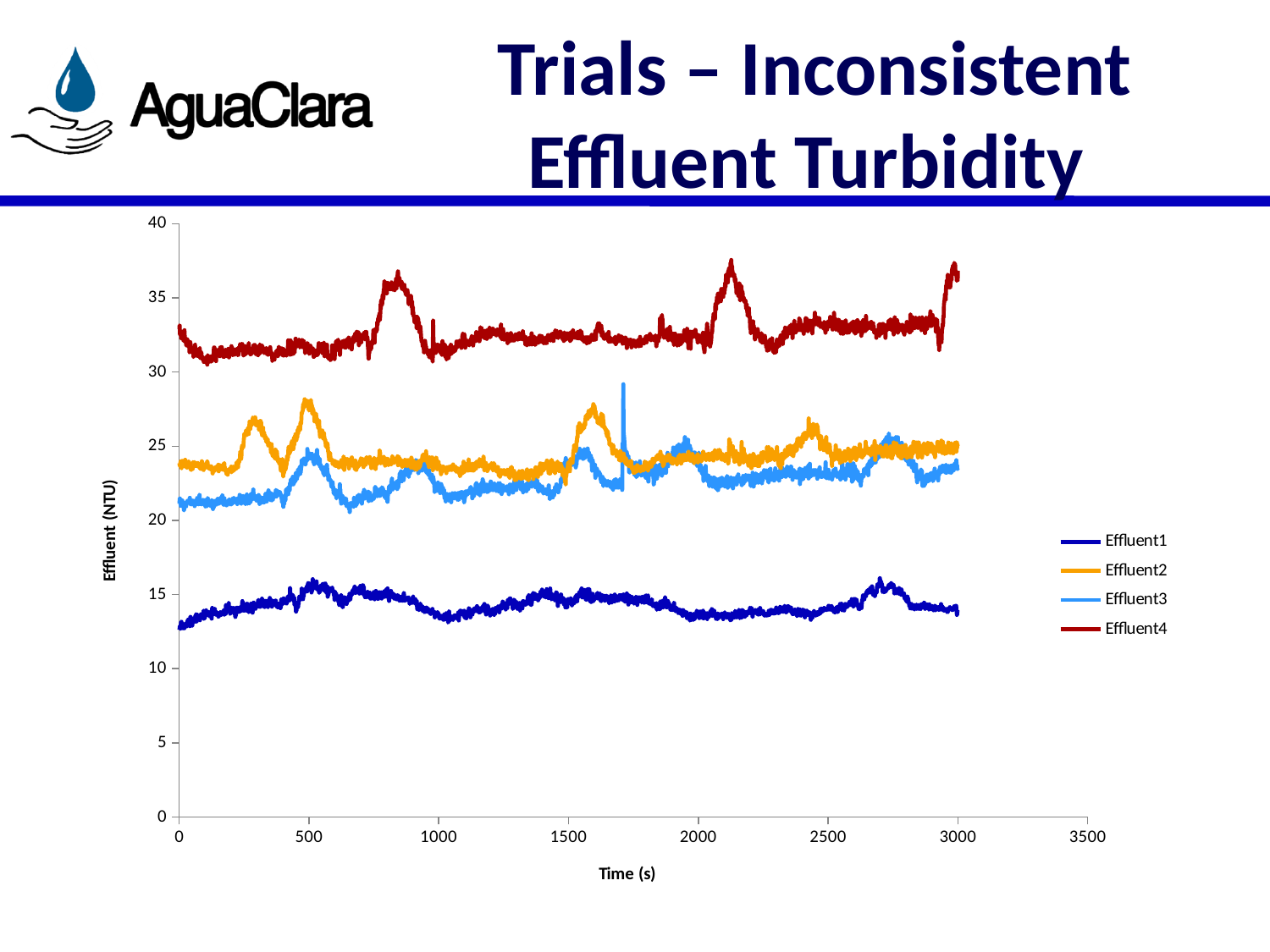
Is the value for Effluent2 at time 1000 greater or less than 25? less Which series has the larger value at time 2000, Effluent4 or Effluent1? Effluent4 Which series has the highest effluent turbidity values throughout the trial? Effluent4 Is the value for Effluent1 at time 0 greater or less than 15? less What kind of chart is shown on the slide? line chart How many series does the legend list? 4 What is the label of the y axis? Effluent (NTU) Is the value for Effluent4 at time 0 greater or less than 30? greater What is the label of the x axis? Time (s) Which series has the lowest effluent turbidity values throughout the trial? Effluent1 Which series has the larger value at time 500, Effluent2 or Effluent3? Effluent2